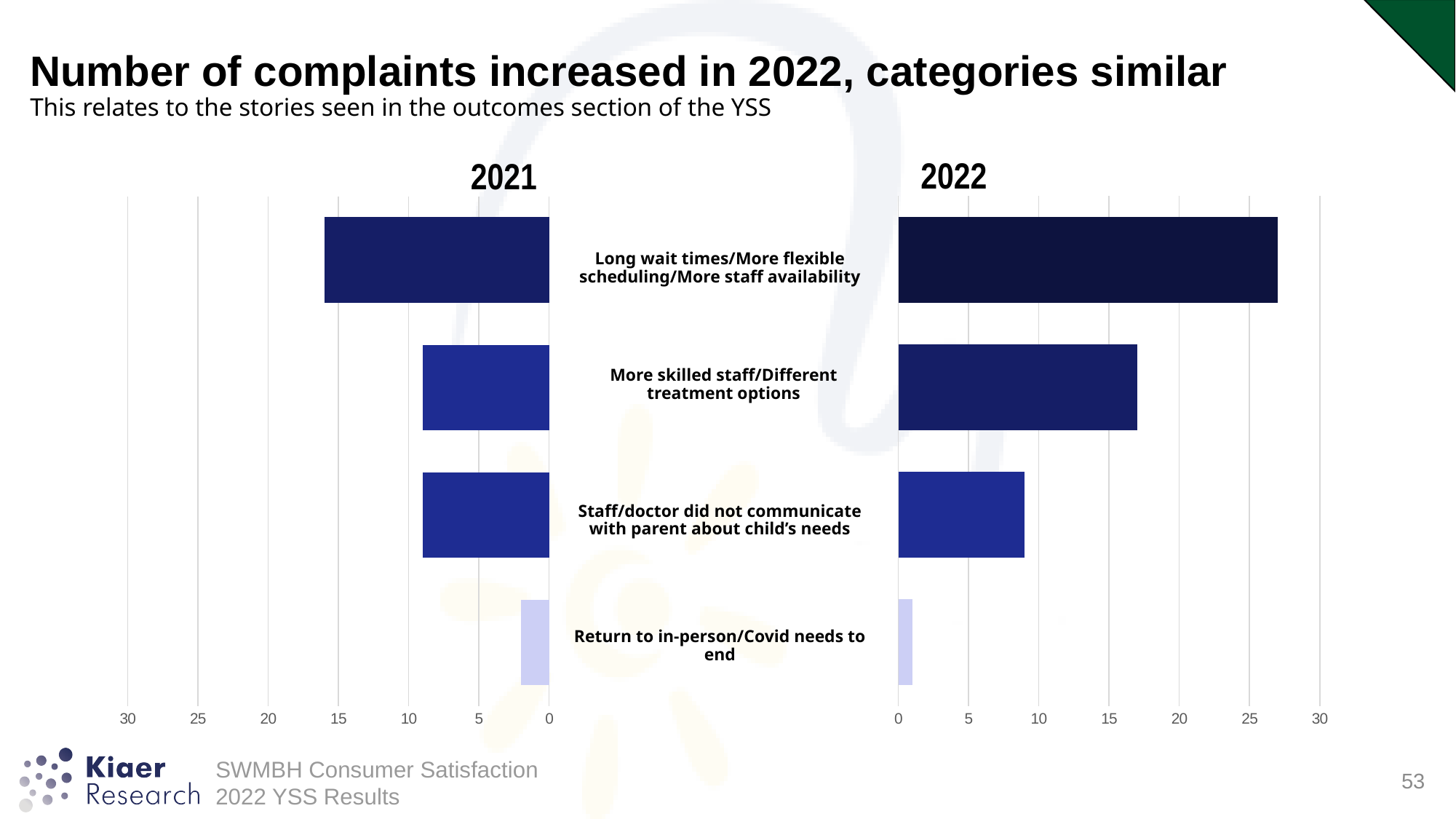
In the 2021 chart, which category has the highest number of complaints? Long wait times/More flexible scheduling/More staff availability In the 2022 chart, is the value for Long wait times/More flexible scheduling/More staff availability greater or less than 25? greater What kind of chart is used for the 2021 and 2022 complaint categories? Bar chart In the 2021 chart, which category has the lowest number of complaints? Return to in-person/Covid needs to end How many complaint categories are shown in the 2022 chart? 4 In the 2022 chart, which is larger: Long wait times/More flexible scheduling/More staff availability or More skilled staff/Different treatment options? Long wait times/More flexible scheduling/More staff availability In the 2022 chart, is the value for Staff/doctor did not communicate with parent about child's needs greater or less than 15? less For Long wait times/More flexible scheduling/More staff availability, which year has the larger value, 2021 or 2022? 2022 In the 2021 chart, is the value for Long wait times/More flexible scheduling/More staff availability greater or less than 10? greater In the 2022 chart, which category has the lowest number of complaints? Return to in-person/Covid needs to end